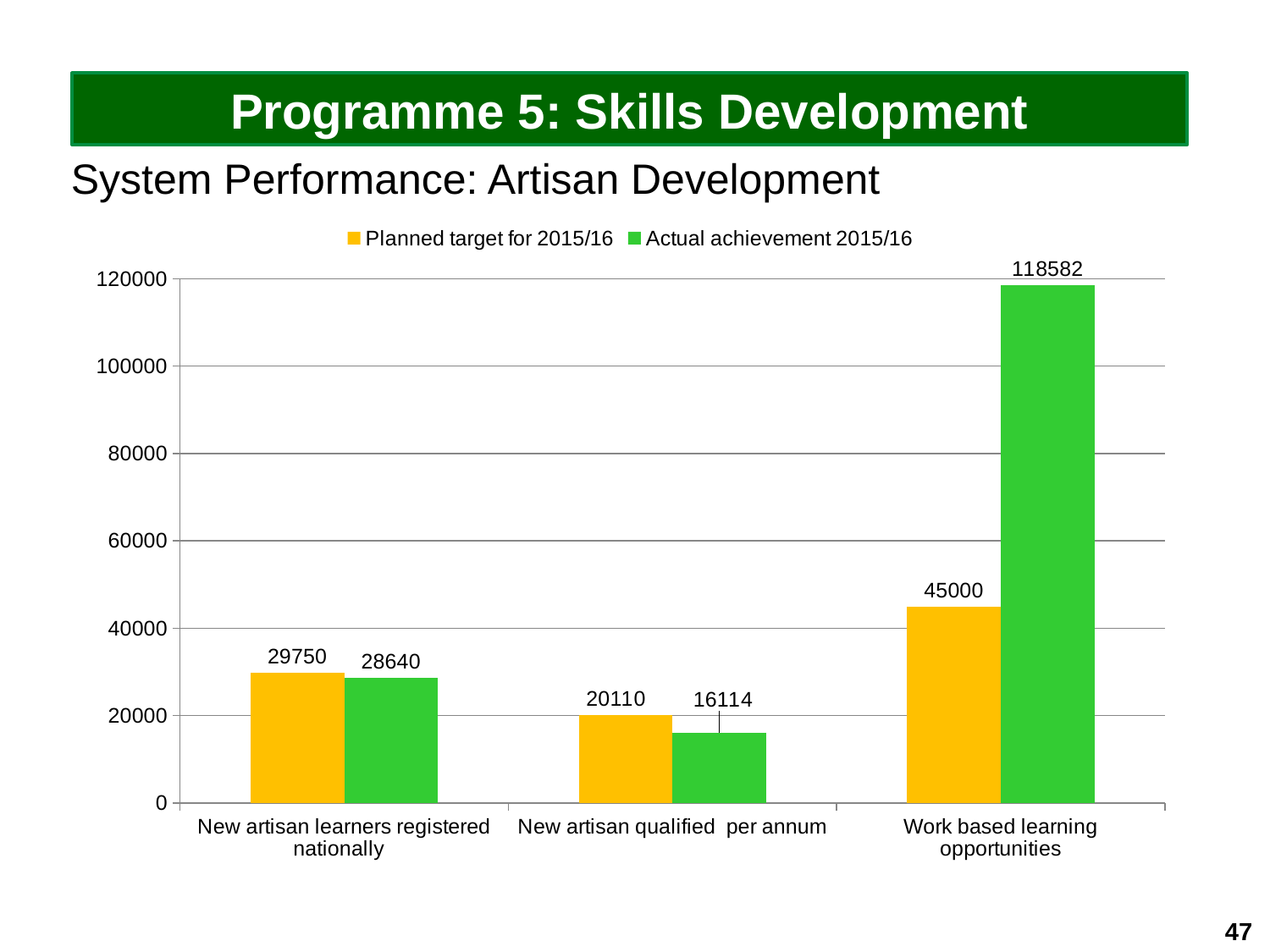
How many series does the legend list? 2 Which category has the lowest planned target for 2015/16? New artisan qualified per annum How many categories are shown on the x axis? 3 What was the actual achievement 2015/16 for New artisan qualified per annum? 16114 Is the actual achievement 2015/16 for Work based learning opportunities greater or less than 100000? greater What was the actual achievement 2015/16 for Work based learning opportunities? 118582 What was the planned target for 2015/16 for New artisan learners registered nationally? 29750 For New artisan learners registered nationally, which is larger: the planned target for 2015/16 or the actual achievement 2015/16? Planned target for 2015/16 Which category has the highest actual achievement 2015/16? Work based learning opportunities What is the difference between the planned target and the actual achievement for New artisan qualified per annum? 3996 What is the difference between the planned target and the actual achievement for Work based learning opportunities? 73582 What kind of chart is shown on the slide? Bar chart